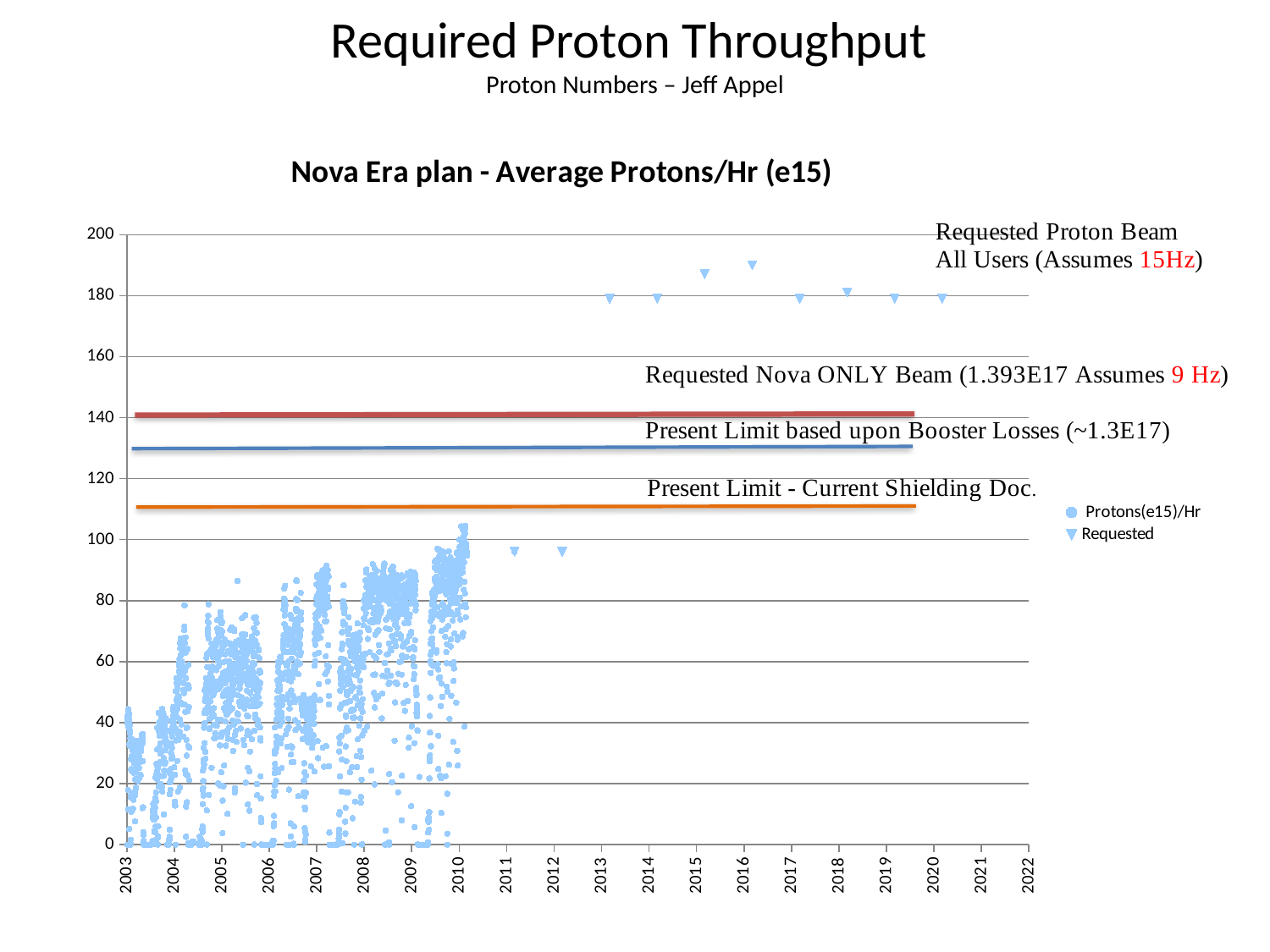
What is the title of the chart? Nova Era plan - Average Protons/Hr (e15) Is the Requested value for 2011 greater or less than 100? less Which is larger, the Requested value for 2012 or for 2013? 2013 Is the Requested value for 2016 greater or less than 180? greater What does the red horizontal line on the chart represent? Requested Nova ONLY Beam (1.393E17 Assumes 9 Hz) Do the Requested values rise or fall from 2011 to 2016? rise Is the Requested value for 2013 greater or less than 160? greater Which year has the highest Requested value? 2016 How many series does the chart legend list? 2 What kind of chart is shown on the slide? scatter chart How many Requested data points are plotted on the chart? 10